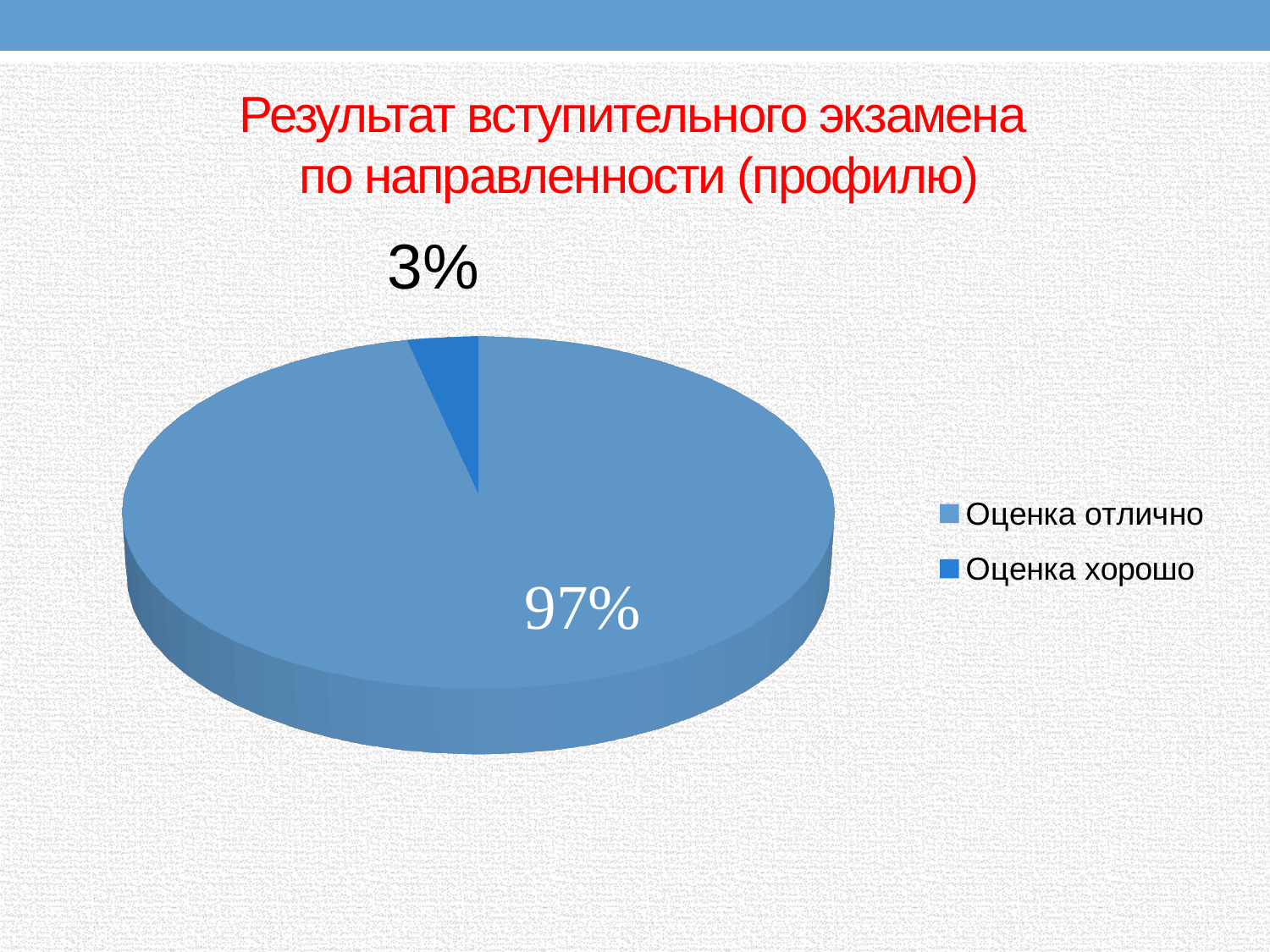
What share of the pie does "Оценка хорошо" have? 3% How many entries does the legend list? 2 Which legend entry is listed first? Оценка отлично What share of the pie does "Оценка отлично" have? 97% What is the difference in percentage points between "Оценка отлично" and "Оценка хорошо"? 94 Which is larger, the share for "Оценка отлично" or for "Оценка хорошо"? Оценка отлично Which category has the largest slice of the pie? Оценка отлично What is the title of the slide containing the chart? Результат вступительного экзамена по направленности (профилю) What kind of chart is shown on the slide? pie chart Which category has the smallest slice of the pie? Оценка хорошо How many slices does the pie chart have? 2